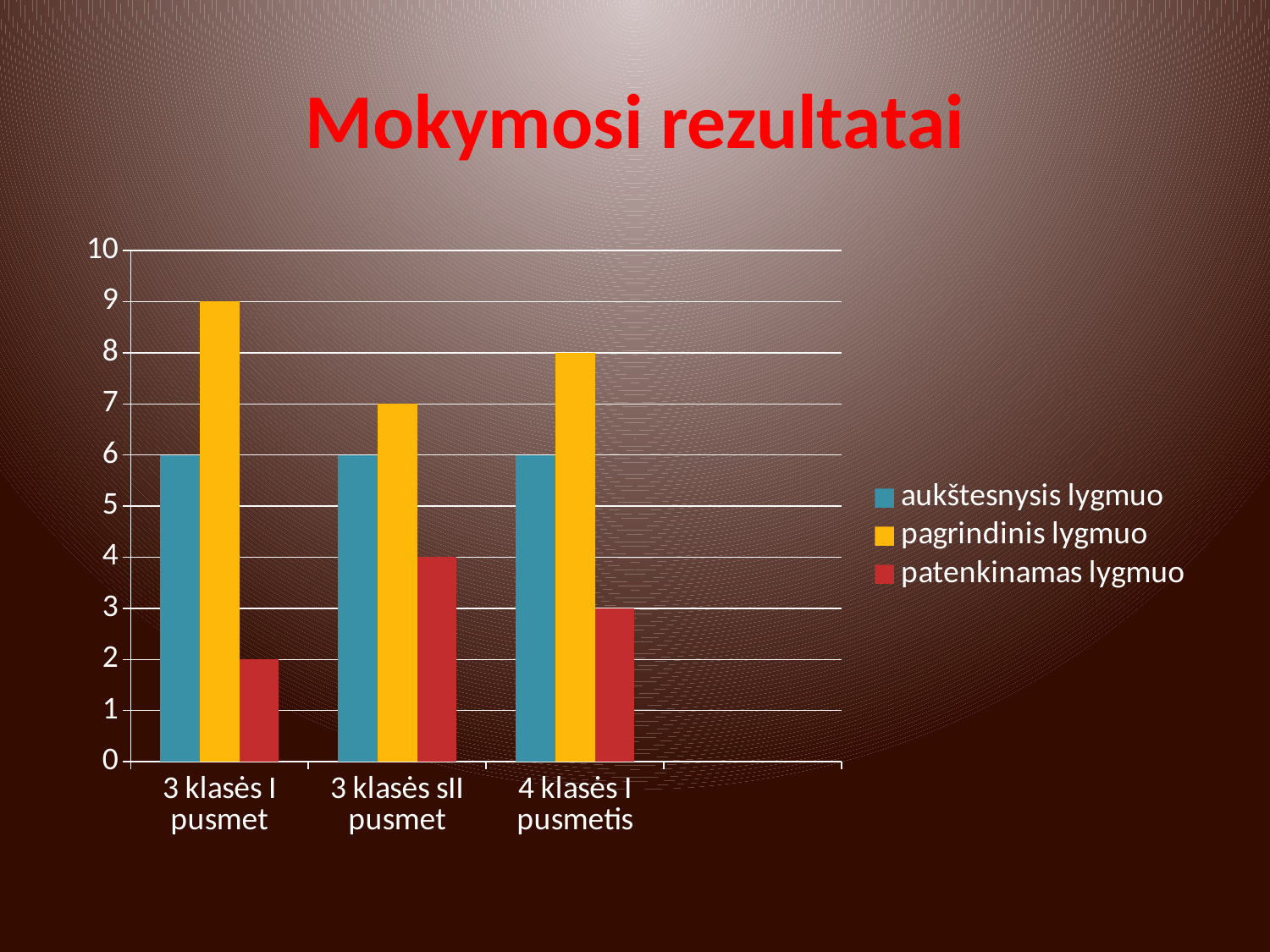
Which category has the highest value for pagrindinis lygmuo? 3 klasės I pusmet What is the difference between pagrindinis lygmuo and patenkinamas lygmuo for 4 klasės I pusmetis? 5 Which category has the lowest value for patenkinamas lygmuo? 3 klasės I pusmet What is the value of aukštesnysis lygmuo for 4 klasės I pusmetis? 6 How many series does the legend list? 3 How many categories are shown on the x axis? 3 What kind of chart is shown on the slide? bar chart What is the value of pagrindinis lygmuo for 3 klasės I pusmet? 9 What is the value of patenkinamas lygmuo for 3 klasės sII pusmet? 4 What is the title of the chart? Mokymosi rezultatai Which is larger for 3 klasės sII pusmet: aukštesnysis lygmuo or pagrindinis lygmuo? pagrindinis lygmuo Which colour represents patenkinamas lygmuo in the chart? red